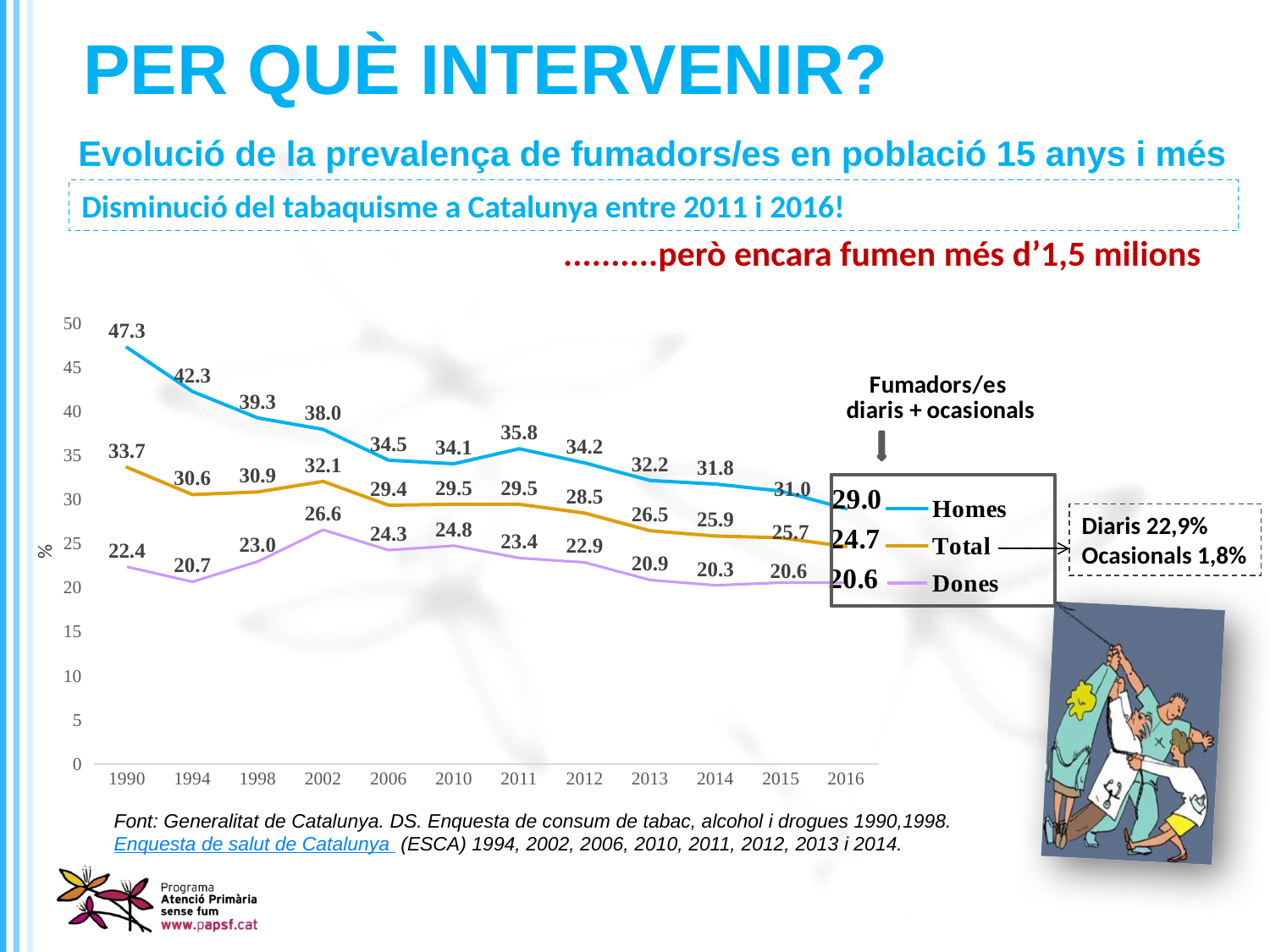
In which year is the Homes series at its highest? 1990 Does the Homes series generally rise or fall from 1990 to 2016? Fall What is the value for Dones in 2002? 26.6 What is the difference between the Homes value and the Dones value in 2016? 8.4 What type of chart is shown on the slide? Line chart In which year is the Total series at its lowest? 2016 How many years are plotted along the x axis of the chart? 12 What is the value for Homes in 1990? 47.3 How many series does the chart legend list? 3 Which series is drawn in purple in the chart? Dones What is the value for Total in 2016? 24.7 Which is larger in 2011: the Homes value or the Total value? Homes